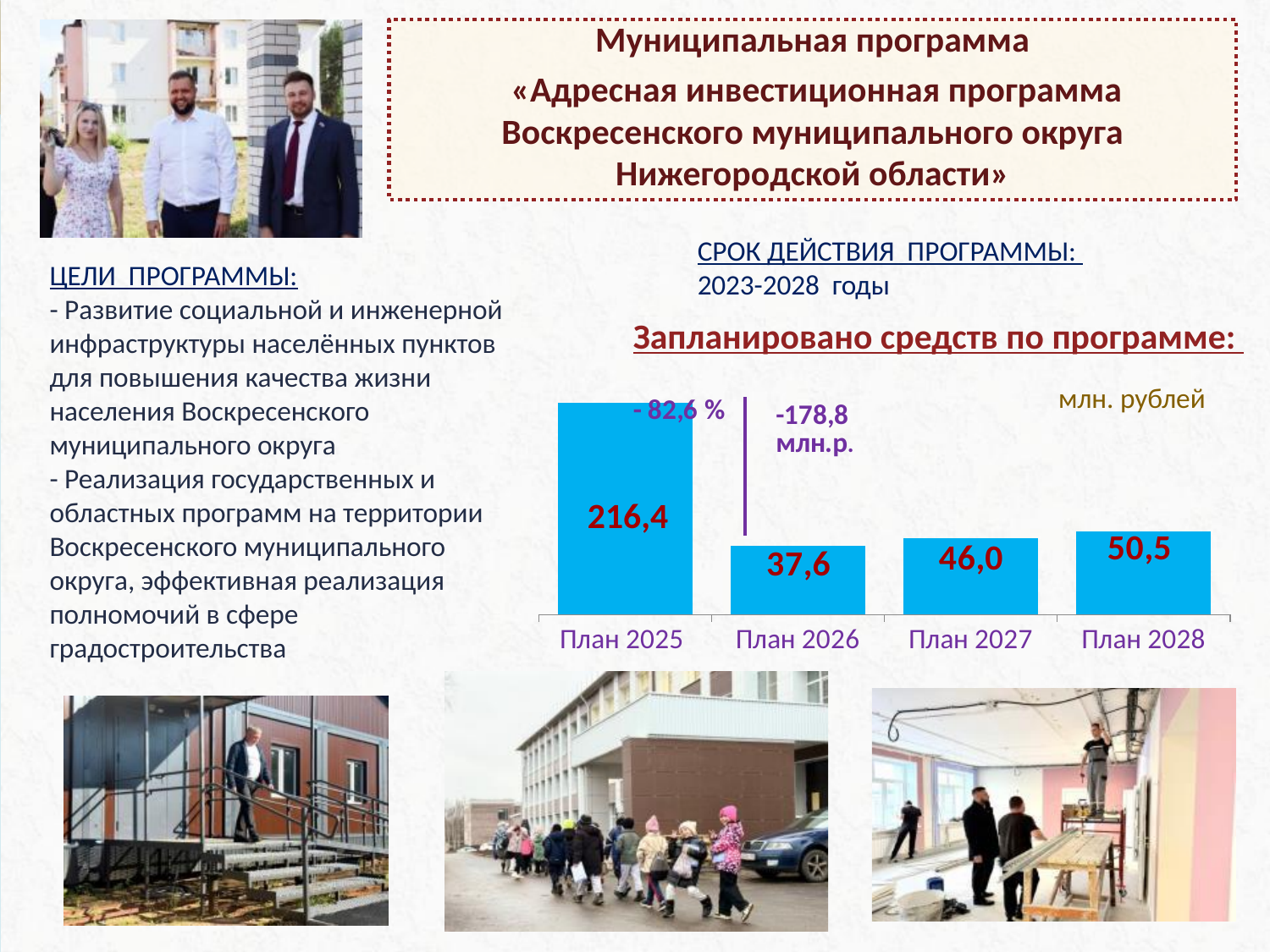
What is the planned amount for План 2028? 50,5 What is the difference between the planned amounts for План 2028 and План 2027? 4,5 Which is larger, the planned amount for План 2027 or План 2028? План 2028 What type of chart is used to show the planned funds? Bar chart What is the planned amount for План 2026? 37,6 Which year has the highest planned amount? План 2025 What is the difference between the planned amounts for План 2025 and План 2026? 178,8 What is the planned amount for План 2027? 46,0 How many years (categories) are shown in the chart? 4 Which year has the lowest planned amount? План 2026 What is the planned amount for План 2025? 216,4 In what units are the chart values given? млн. рублей